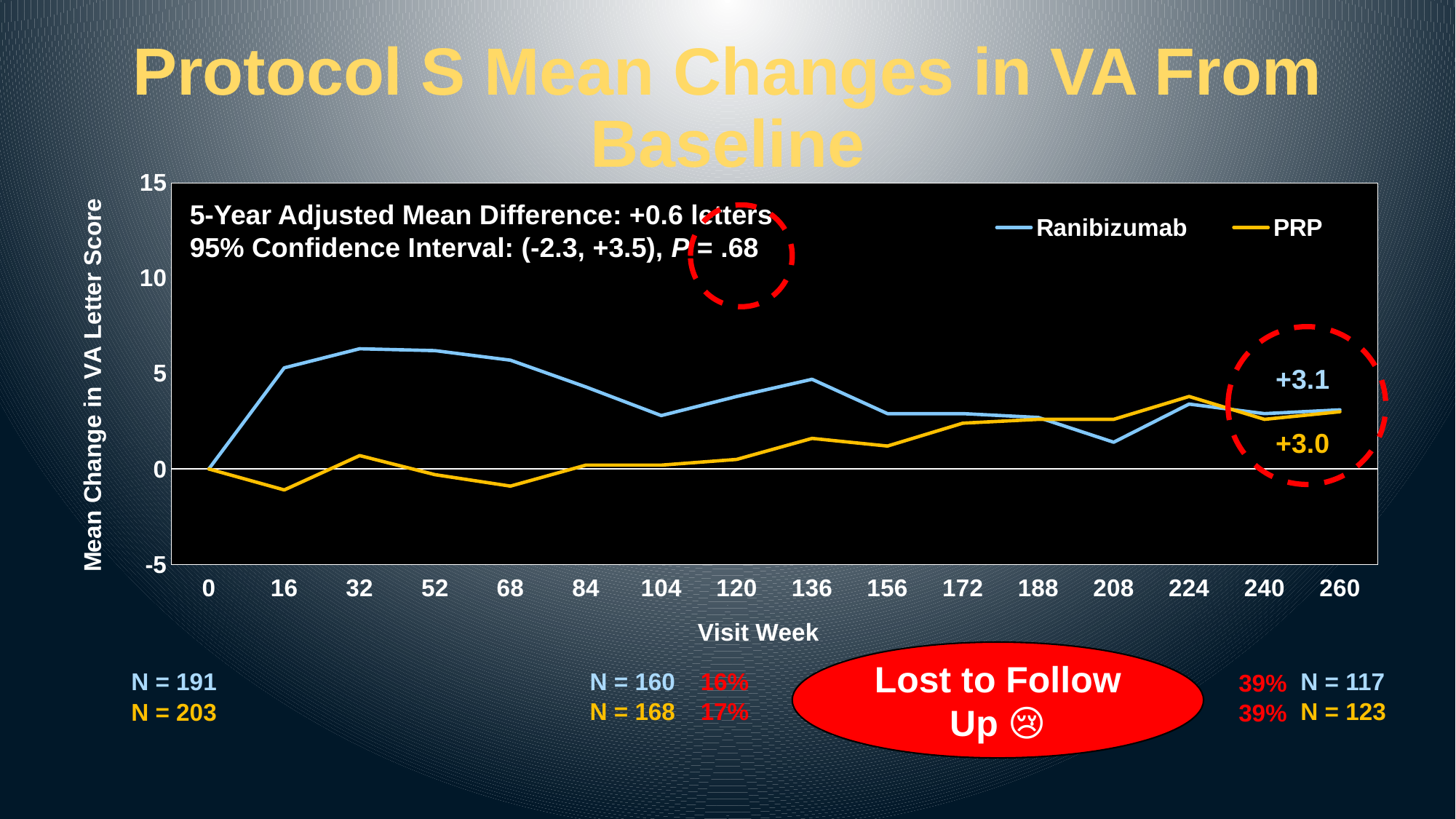
What kind of chart is shown on the slide? line chart What is the title of the x axis? Visit Week What is the mean change in VA letter score for PRP at visit week 260? +3.0 How many series does the legend list? 2 Is the value for PRP at visit week 16 greater or less than 0? less Does the PRP line rise or fall between visit week 68 and visit week 224? rise How many visit weeks are marked along the x axis? 16 What is the difference between the Ranibizumab and PRP values at visit week 260? 0.1 What is the mean change in VA letter score for Ranibizumab at visit week 260? +3.1 Is the value for Ranibizumab at visit week 32 greater or less than 5? greater What is the value of both series at visit week 0? 0 At visit week 68, which series has the higher value, Ranibizumab or PRP? Ranibizumab